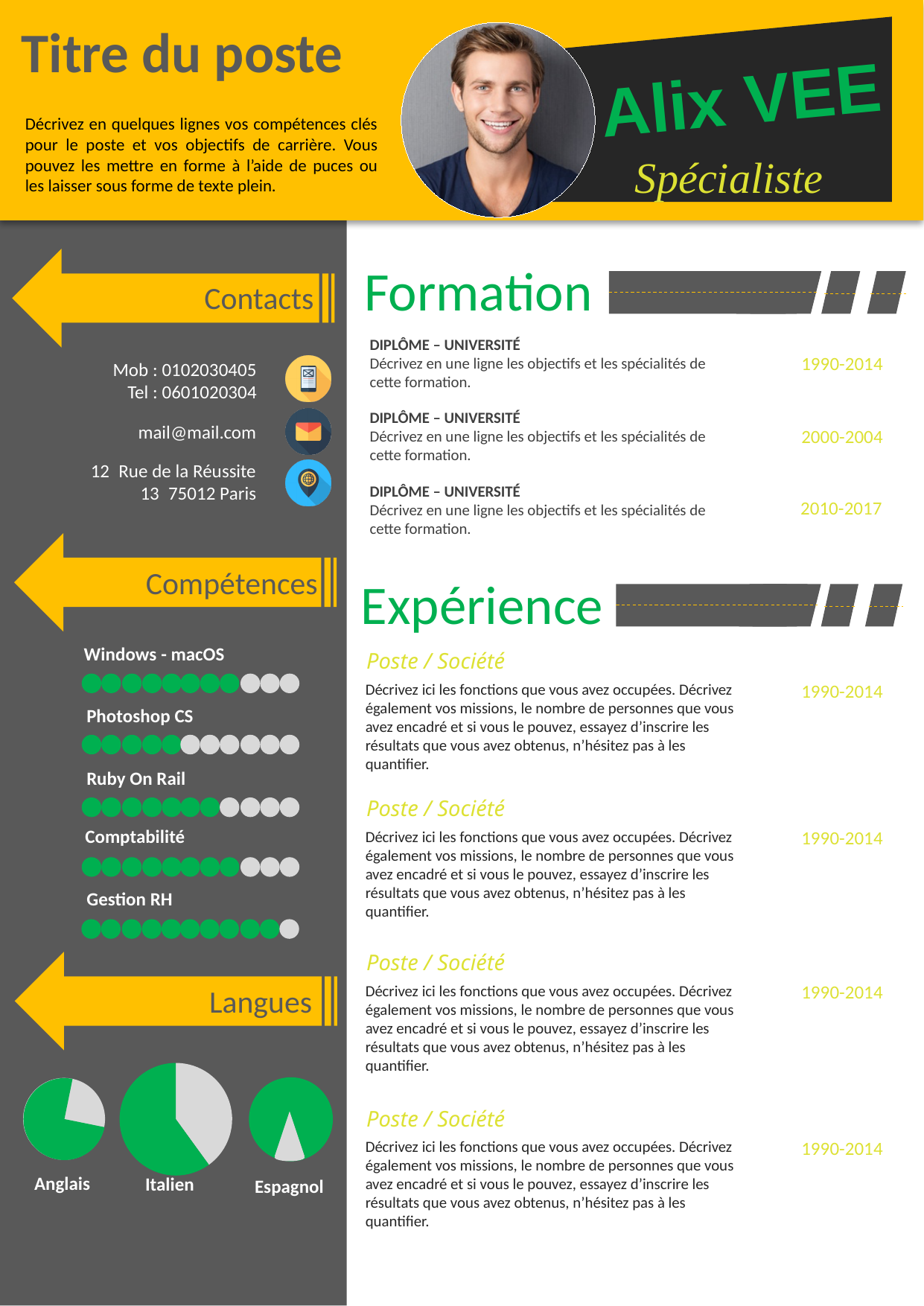
What kind of chart is used to show the language levels under "Langues"? pie chart In the "Compétences" section, which skill has the fewest green dots? Photoshop CS In the "Compétences" section, which skill has the most green dots? Gestion RH How many pie charts are shown in the "Langues" section? 3 Among the language pie charts, which language has the smallest green share? Italien Which languages are labelled under the pie charts in the "Langues" section? Anglais, Italien, Espagnol What two colours are used in the language pie charts? green and grey In the "Compétences" section, how many dots are filled green for Photoshop CS? 6 In the language pie charts, is the green share larger for Anglais or for Italien? Anglais In the "Compétences" section, how many dots are filled green for Gestion RH? 11 In the language pie charts, is the green share larger for Espagnol or for Italien? Espagnol How many skills are rated with dots in the "Compétences" section? 5